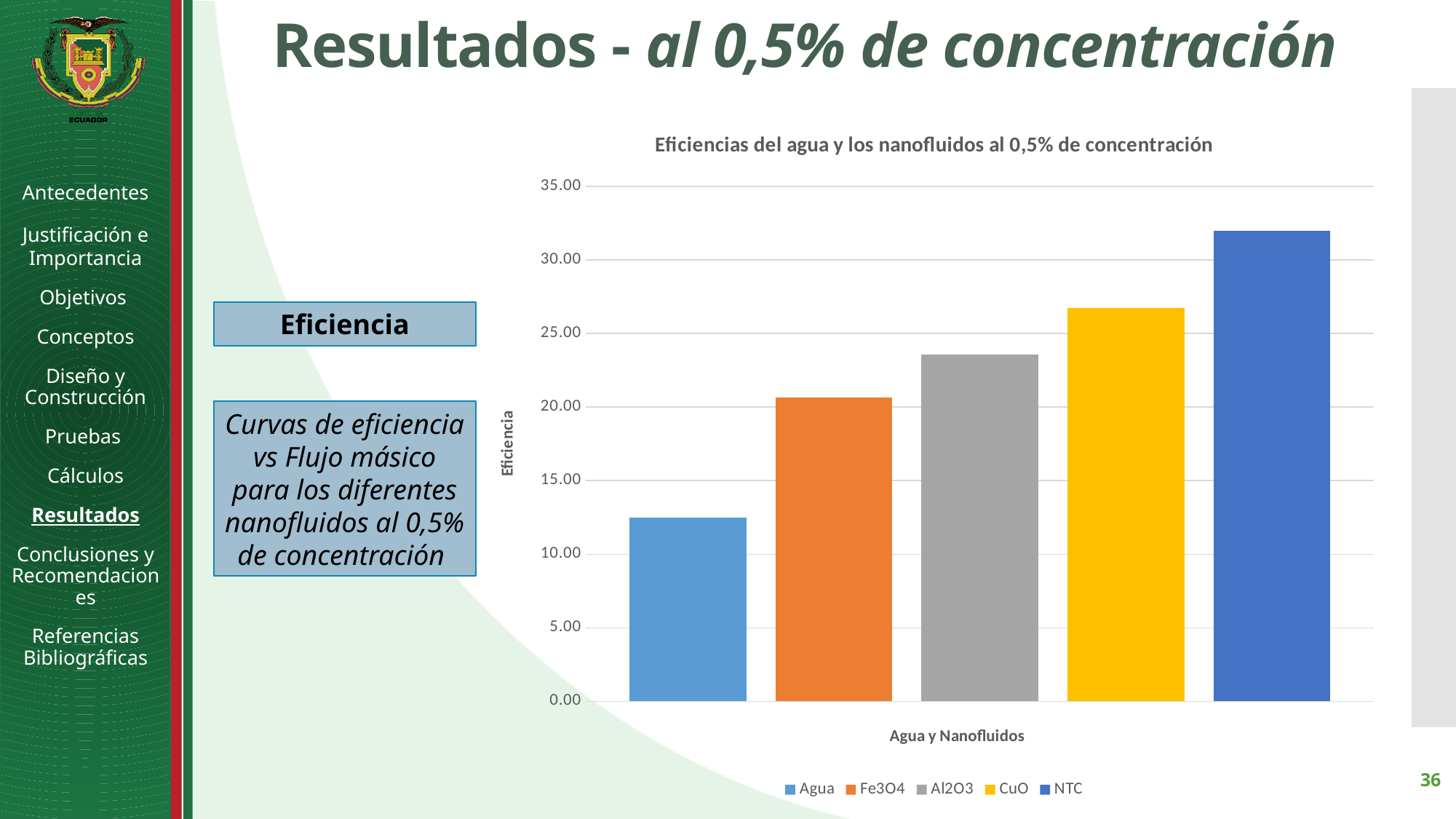
Is the efficiency value for Fe3O4 greater or less than 25? less Is the efficiency value for Agua greater or less than 15? less What is the title of the chart? Eficiencias del agua y los nanofluidos al 0,5% de concentración Is the efficiency value for Al2O3 greater or less than 20? greater Which fluid has the lowest efficiency in the chart? Agua Which fluid has the highest efficiency in the chart? NTC Do the bar values rise or fall from left to right across the chart? rise What kind of chart is shown on the slide? bar chart How many entries does the chart legend list? 5 Which has a higher efficiency, CuO or Al2O3? CuO How many bars are plotted in the chart? 5